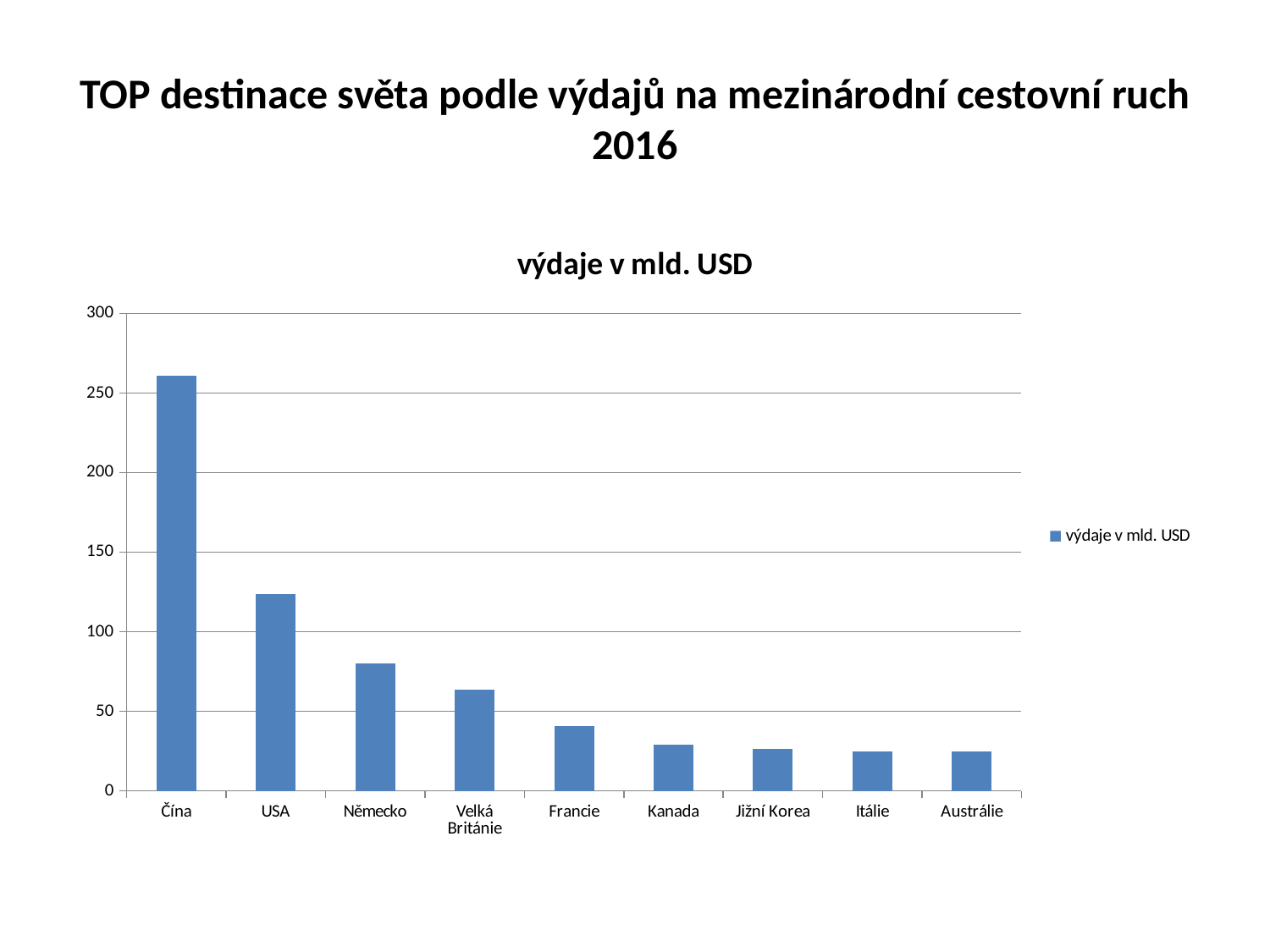
Which country has the highest value in the chart? Čína Is the value for USA greater or less than 100? greater How many countries are shown on the x axis of the chart? 9 Is the value for Čína greater or less than 250? greater What is the title of the chart? výdaje v mld. USD How many series does the legend list? 1 Do the values rise or fall moving from left to right along the x axis? fall Is the value for Velká Británie greater or less than 50? greater What kind of chart is shown on the slide? bar chart Which has the larger value, USA or Německo? USA